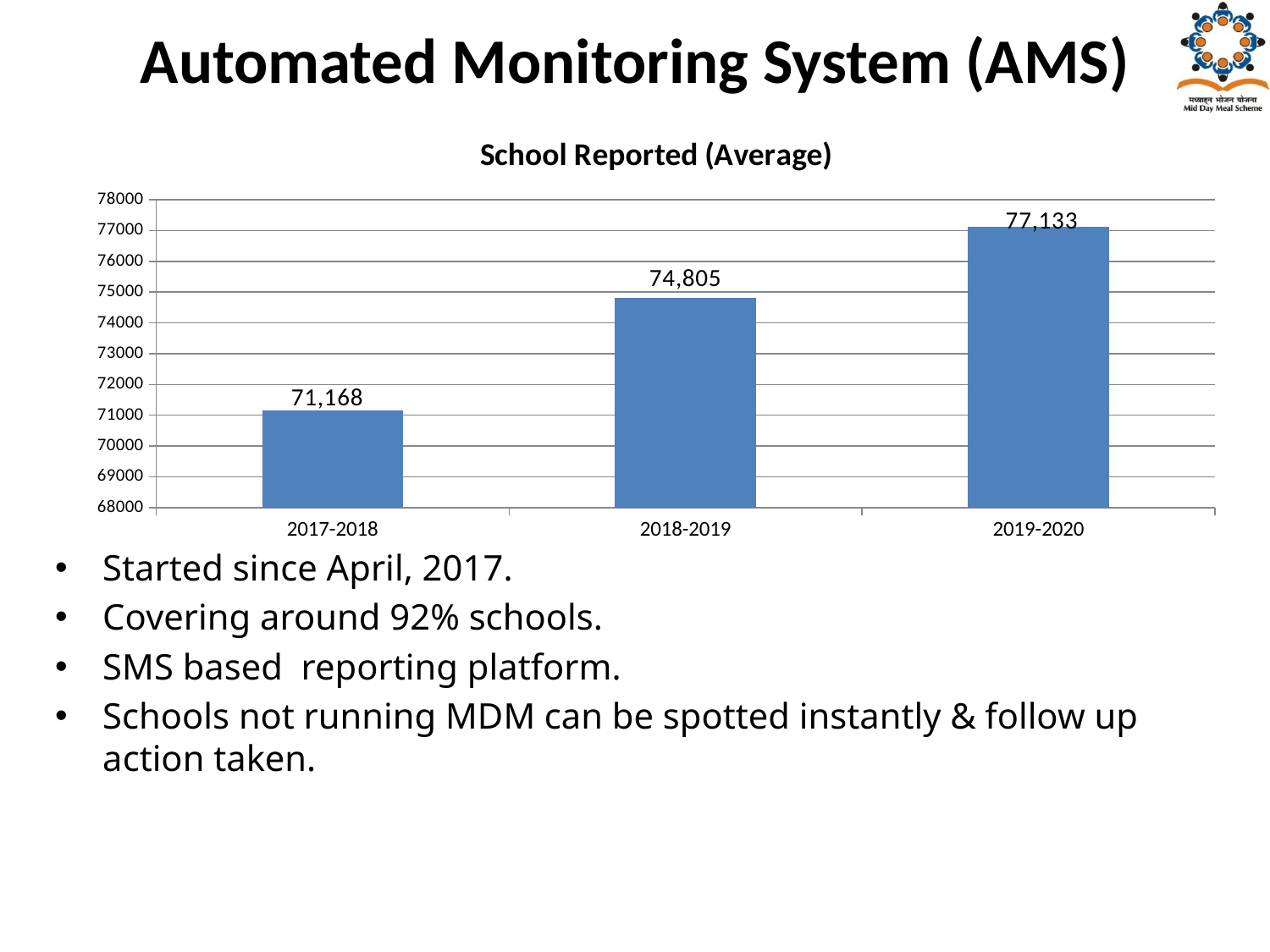
What is the value for 2017-2018? 71,168 Is the value for 2018-2019 greater or less than 74000? greater What is the difference between the values for 2019-2020 and 2017-2018? 5,965 Which year has the highest value? 2019-2020 Which is larger, the value for 2018-2019 or the value for 2019-2020? 2019-2020 What is the value for 2018-2019? 74,805 What is the difference between the values for 2018-2019 and 2017-2018? 3,637 How many years are shown on the x axis? 3 Do the values rise or fall from 2017-2018 to 2019-2020? rise Which year has the lowest value? 2017-2018 What kind of chart is shown on the slide? bar chart What is the value for 2019-2020? 77,133